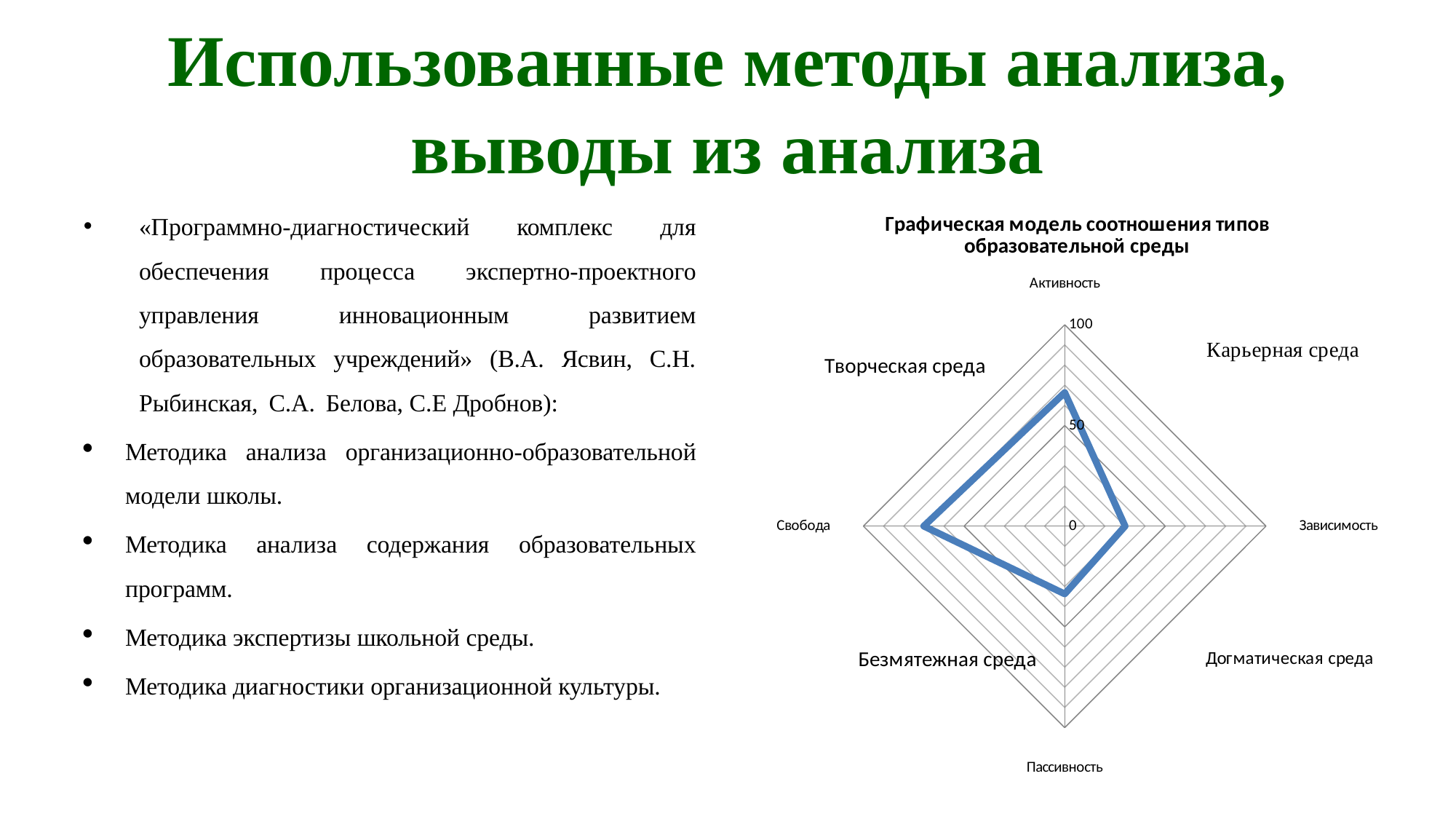
Which is larger, the value for Свобода or the value for Зависимость? Свобода Is the value for Зависимость greater or less than 50? less What is the maximum value shown on the chart's axis scale? 100 Is the value for Активность greater or less than 50? greater Which is larger, the value for Активность or the value for Пассивность? Активность Is the value for Пассивность greater or less than 50? less What is the title of the chart? Графическая модель соотношения типов образовательной среды How many axes (categories) does the radar chart have? 4 What kind of chart is shown on the slide? radar chart